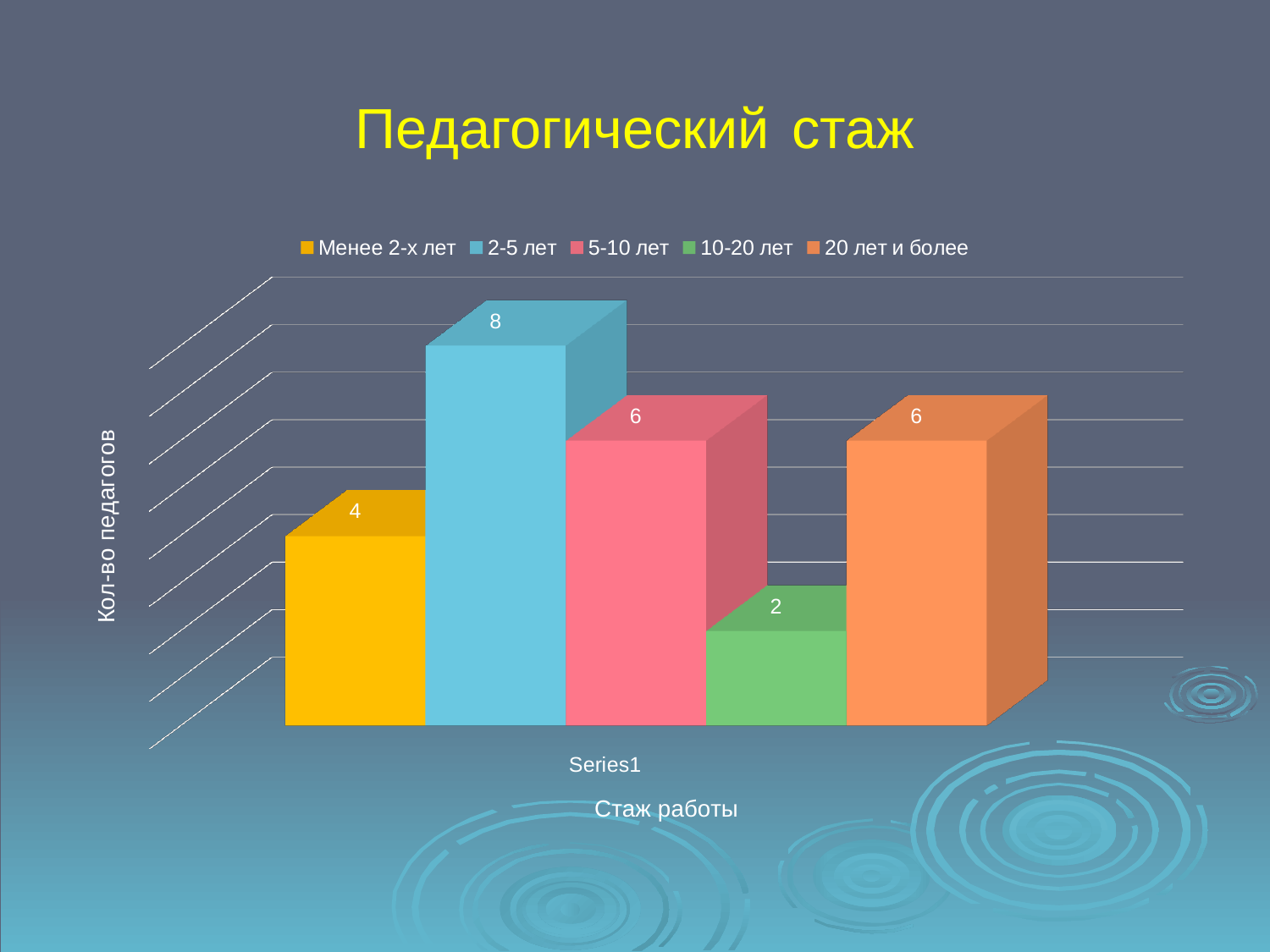
Which legend entry has the lowest value? 10-20 лет How many bars are plotted in the chart? 5 Which legend entry has the highest value? 2-5 лет What is the value for "10-20 лет"? 2 What kind of chart is shown on the slide? bar chart What is the difference between the values for "2-5 лет" and "10-20 лет"? 6 What is the title of the slide? Педагогический стаж Which is larger, the value for "Менее 2-х лет" or the value for "5-10 лет"? 5-10 лет What is the value for "20 лет и более"? 6 How many entries does the legend list? 5 What is the value for "Менее 2-х лет"? 4 What is the value for "2-5 лет"? 8